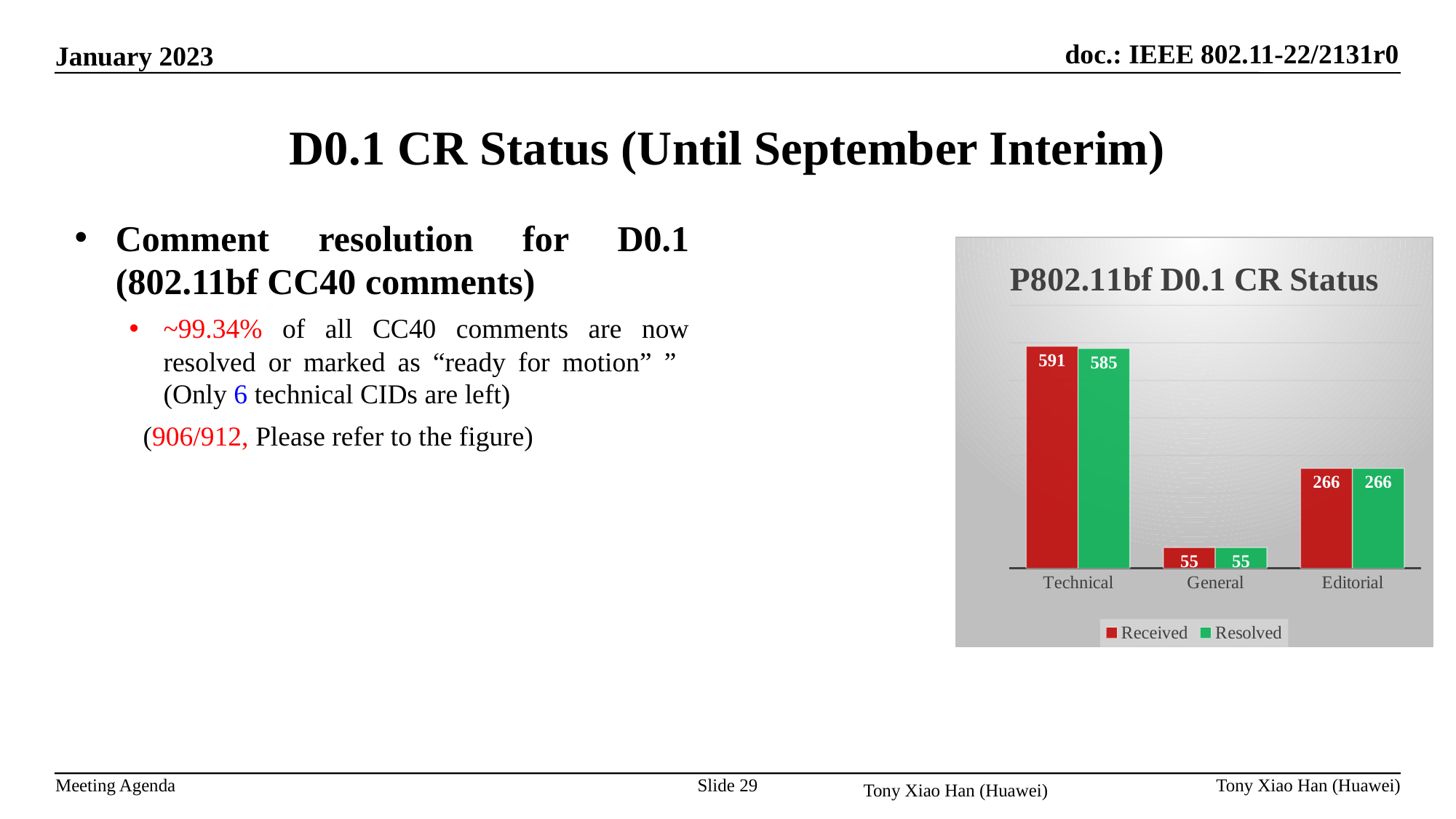
What is the Resolved value for Editorial? 266 What is the Resolved value for Technical? 585 Which category has the highest Received value? Technical Which is larger, the Received value for Editorial or the Received value for General? Editorial What is the Received value for Technical? 591 What is the Received value for General? 55 What type of chart is shown? Bar chart How many categories are shown on the x axis? 3 How many series does the legend list? 2 What is the difference between the Received values for Technical and Editorial? 325 What is the difference between Received and Resolved for Technical? 6 Which category has the lowest Resolved value? General